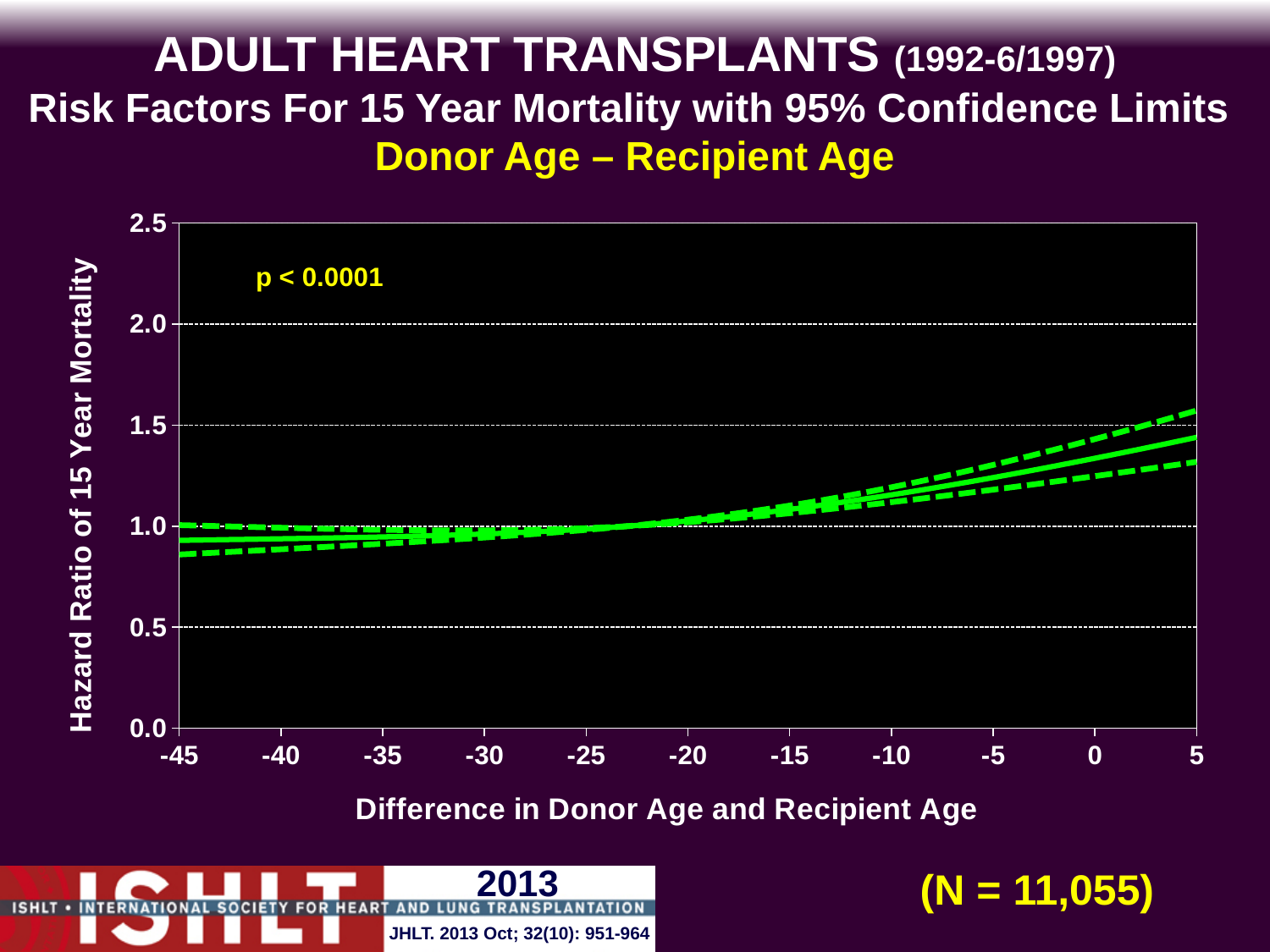
Is the hazard ratio at a donor-recipient age difference of -45 greater or less than 1.5? less Does the hazard ratio rise or fall as the difference in donor age and recipient age increases from -45 to 5? rise Is the hazard ratio at a donor-recipient age difference of -30 greater or less than 1.5? less How many tick labels are shown on the y axis? 6 What is the highest value shown on the y axis? 2.5 Is the hazard ratio at a donor-recipient age difference of 5 greater or less than 1.0? greater What p-value is printed on the chart? p < 0.0001 How many tick labels are shown on the x axis? 11 What kind of chart is shown on the slide? line chart What sample size (N) is shown on the slide? N = 11,055